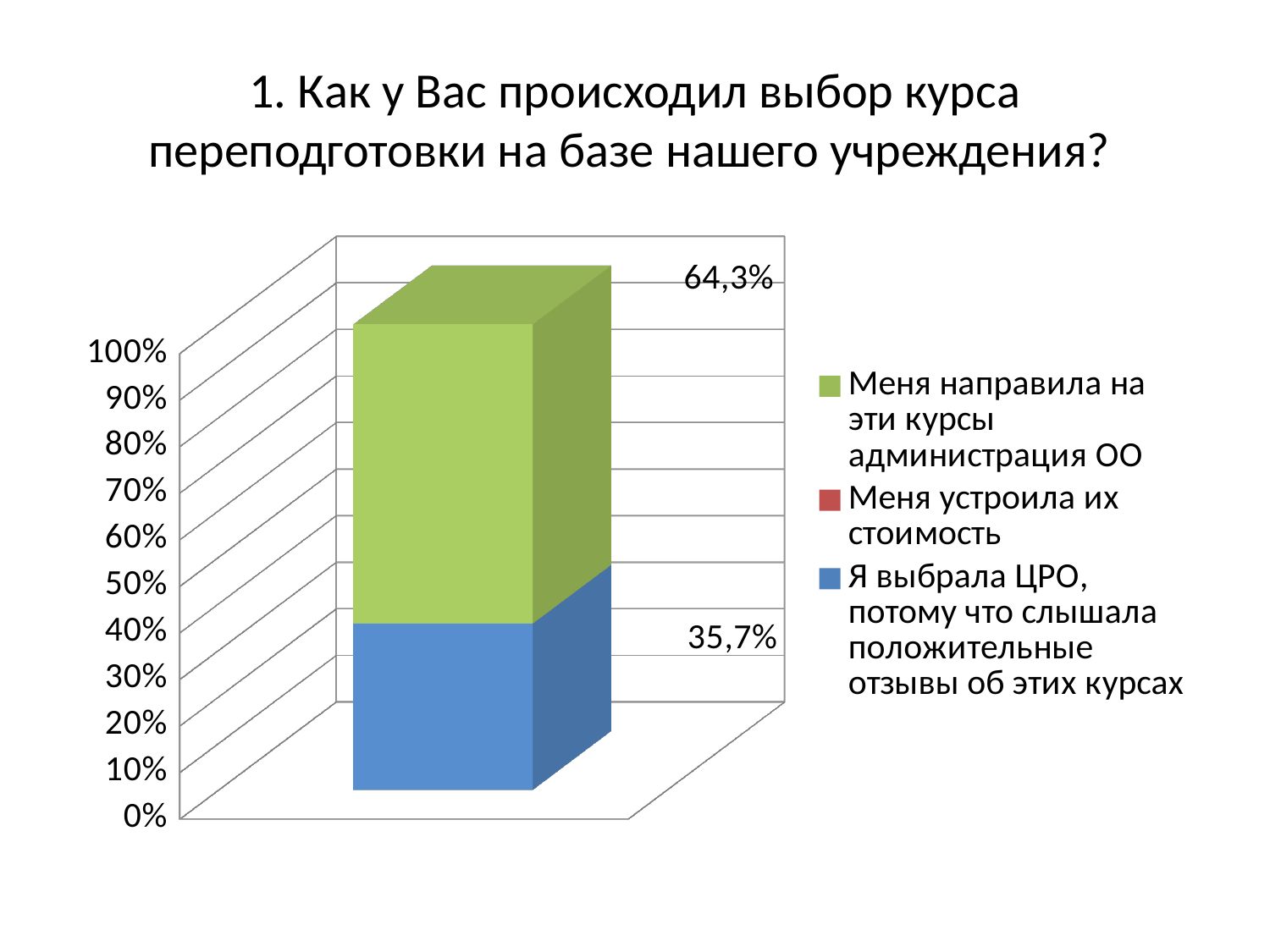
Which is larger: the value for "Меня направила на эти курсы администрация ОО" or the value for "Я выбрала ЦРО, потому что слышала положительные отзывы об этих курсах"? Меня направила на эти курсы администрация ОО Which of the two labelled segments has the smaller value? Я выбрала ЦРО, потому что слышала положительные отзывы об этих курсах What value is shown for the series "Я выбрала ЦРО, потому что слышала положительные отзывы об этих курсах"? 35,7% What is the title of the chart? 1. Как у Вас происходил выбор курса переподготовки на базе нашего учреждения? What is the difference between the 64,3% segment and the 35,7% segment? 28,6% How many bars are plotted in the chart? 1 What kind of chart is shown on the slide? Stacked bar chart What colour represents the series "Меня устроила их стоимость" in the legend? Red How many series does the legend list? 3 Which series has the largest labelled value in the chart? Меня направила на эти курсы администрация ОО What value is shown for the series "Меня направила на эти курсы администрация ОО"? 64,3% What is the total of the two labelled segments in the stacked bar? 100%